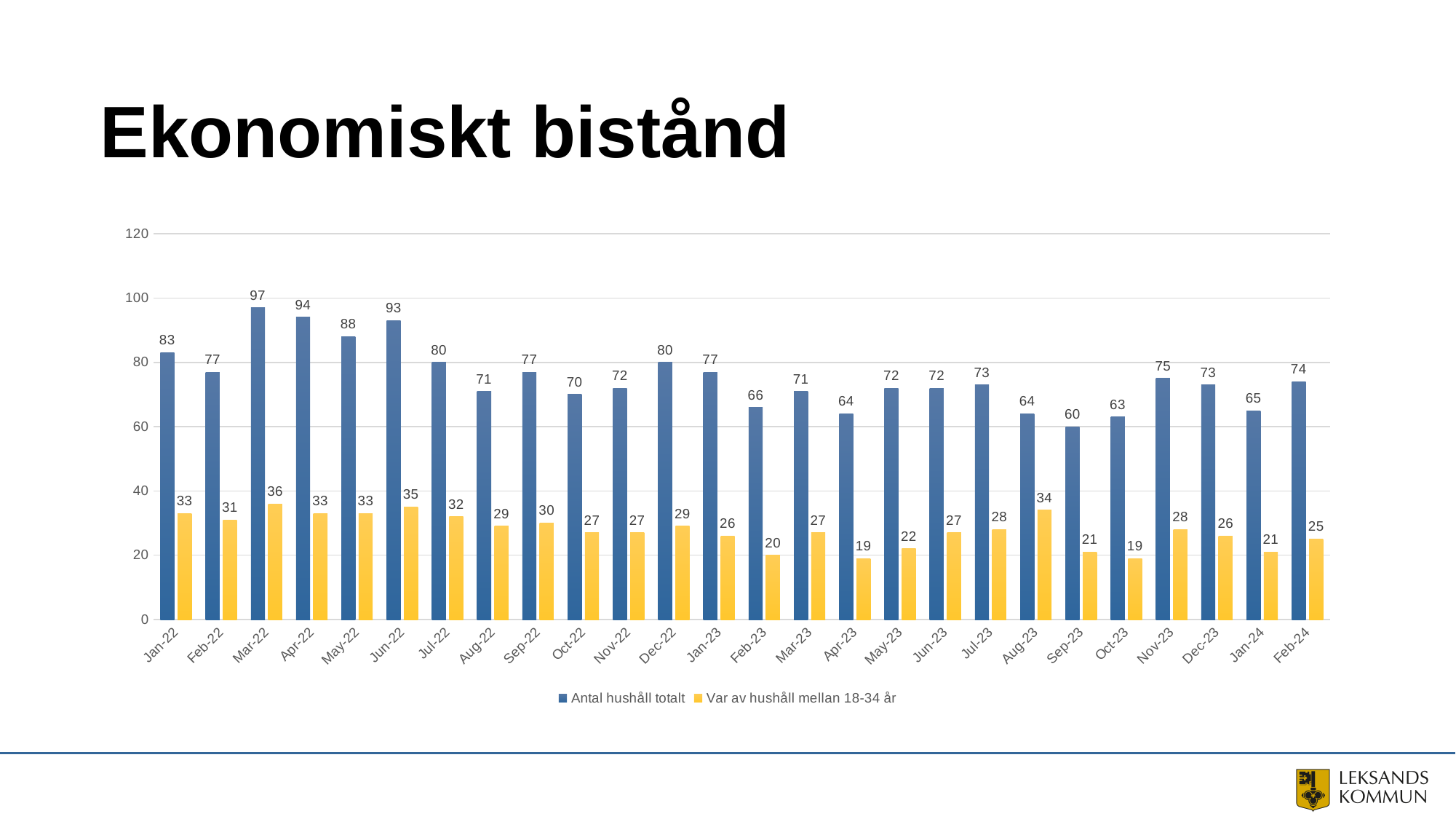
What is the value of "Antal hushåll totalt" for Sep-23? 60 Which is larger: "Antal hushåll totalt" in Jun-22 or in Apr-22? Apr-22 What is the title of the slide containing the chart? Ekonomiskt bistånd What is the difference between "Antal hushåll totalt" and "Var av hushåll mellan 18-34 år" in Jan-22? 50 How many series does the legend list? 2 Which month has the highest value for "Antal hushåll totalt"? Mar-22 What is the value of "Var av hushåll mellan 18-34 år" for Feb-24? 25 Which month has the lowest value for "Antal hushåll totalt"? Sep-23 Which month has the highest value for "Var av hushåll mellan 18-34 år"? Mar-22 How many months are shown on the x axis? 26 What is the value of "Antal hushåll totalt" for Mar-22? 97 What kind of chart is shown on the slide? Bar chart